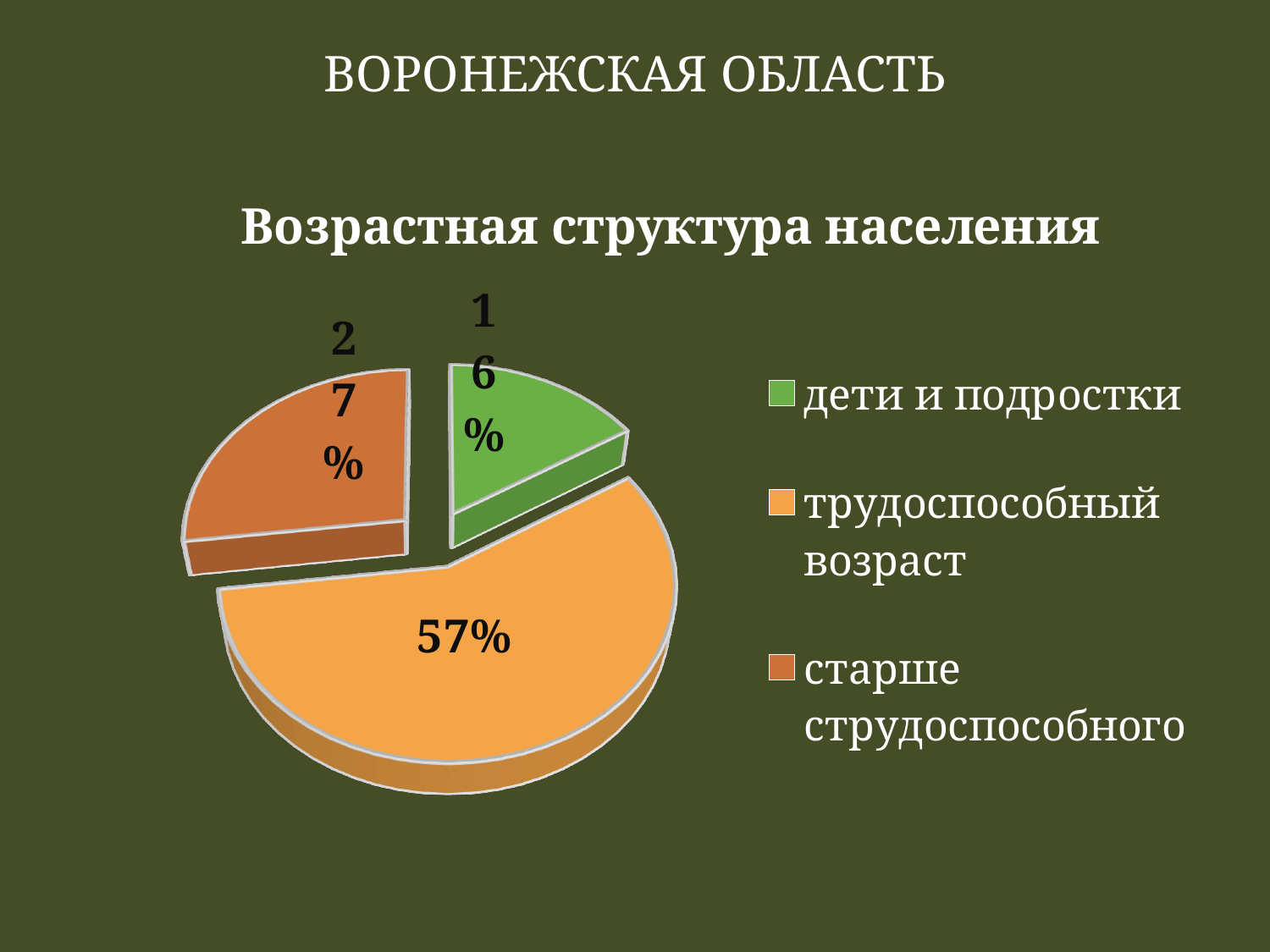
What is the title of the chart? Возрастная структура населения What kind of chart is shown on the slide? pie chart Which category has the smallest share of the pie? дети и подростки Which category has the largest share of the pie? трудоспособный возраст How many slices does the pie chart have? 3 How many entries does the legend list? 3 What share of the population is дети и подростки? 16% Which is larger: the share of дети и подростки or the share of старше трудоспособного? старше трудоспособного What colour is the slice for трудоспособный возраст? orange What share of the population is in the трудоспособный возраст category? 57% What share of the population is старше трудоспособного? 27% What is the difference between the share of трудоспособный возраст and the share of старше трудоспособного? 30%